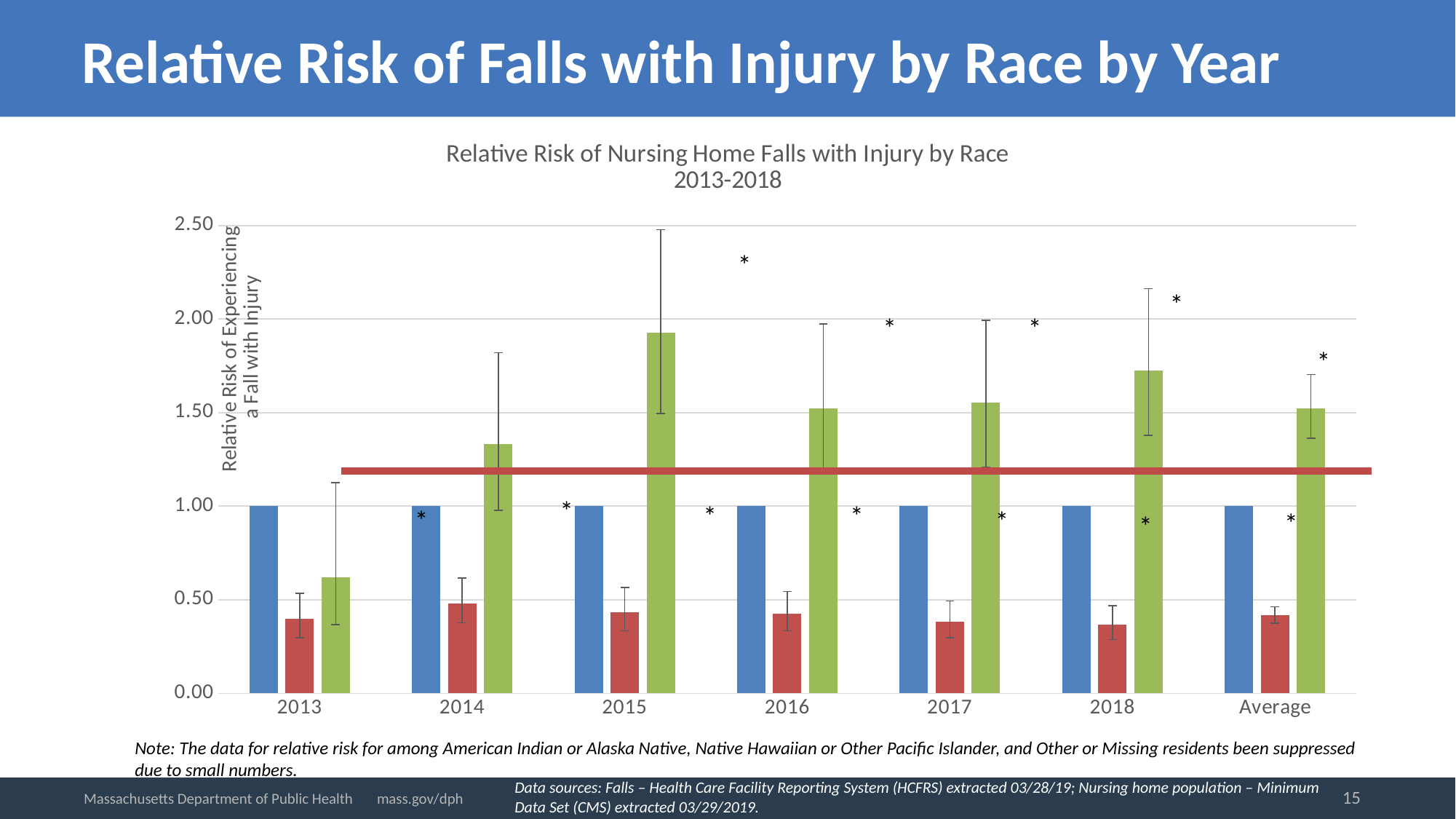
Is the value of the red bar for 2018 greater or less than 0.50? less What is the value of the blue bar for 2013? 1.00 What kind of chart is shown on the slide? bar chart Is the value of the green bar for 2018 greater or less than 1.50? greater What is the title of the chart? Relative Risk of Nursing Home Falls with Injury by Race 2013-2018 Do the green bars rise or fall from 2013 to 2015? rise In which category is the green bar the lowest? 2013 How many categories are shown along the x axis? 7 For 2016, which is larger, the blue bar or the red bar? the blue bar In which year is the green bar the highest? 2015 Is the value of the green bar for 2013 greater or less than 1.00? less